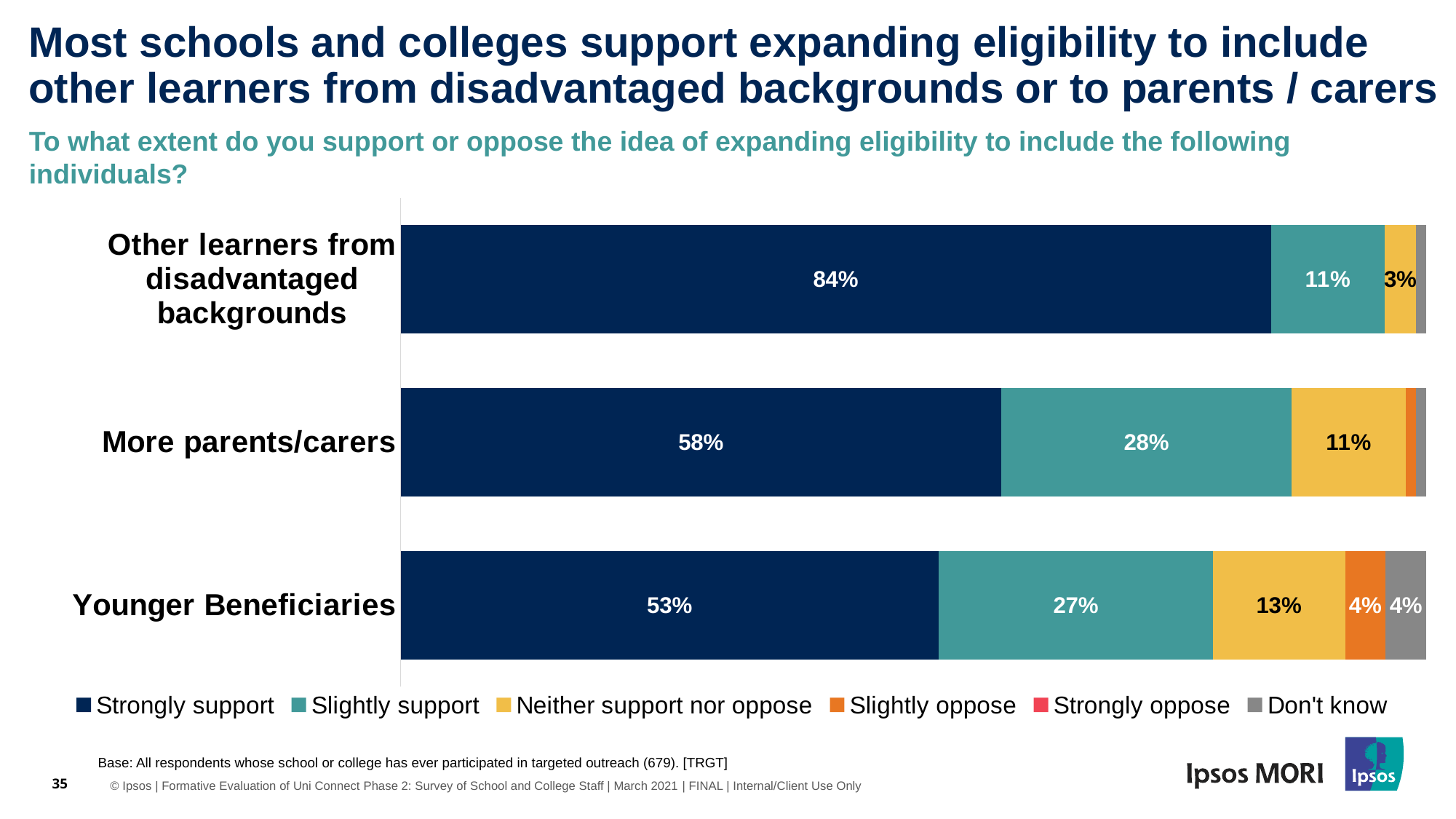
Which category has the highest share of respondents who strongly support expanding eligibility? Other learners from disadvantaged backgrounds What percentage of respondents strongly support expanding eligibility to other learners from disadvantaged backgrounds? 84% How many series does the legend list? 6 What percentage of respondents slightly oppose expanding eligibility to younger beneficiaries? 4% What colour represents the 'Strongly support' series in the chart? Dark navy blue What is the difference between the strongly support percentage for other learners from disadvantaged backgrounds and for more parents/carers? 26 percentage points Which category has the lowest share of respondents who strongly support expanding eligibility? Younger Beneficiaries Which has a larger slightly support share: more parents/carers or younger beneficiaries? More parents/carers What kind of chart is shown on the slide? Stacked bar chart What percentage of respondents neither support nor oppose expanding eligibility to younger beneficiaries? 13% How many categories are shown on the chart? 3 What percentage of respondents slightly support expanding eligibility to more parents/carers? 28%